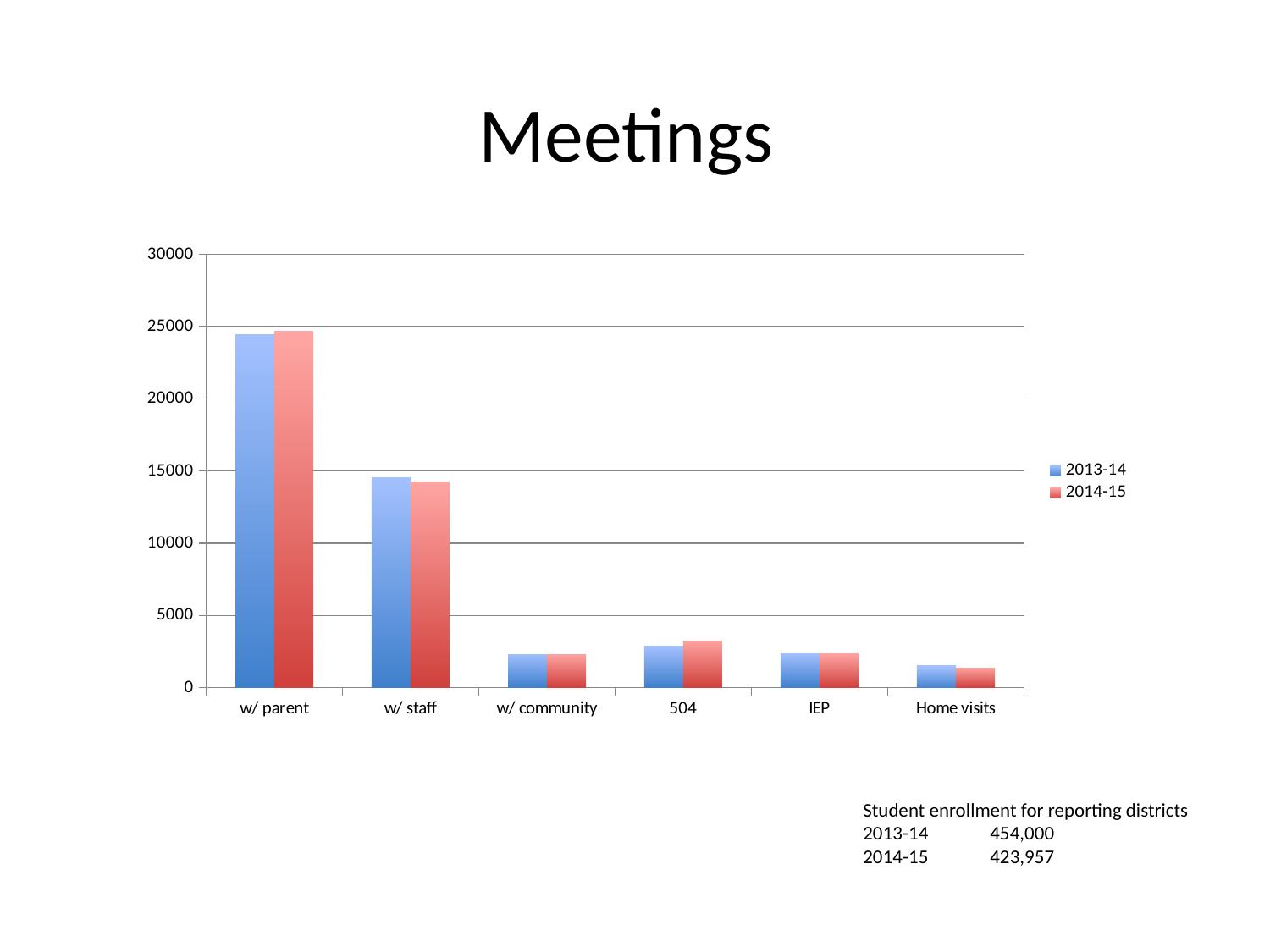
Which category has the highest number of meetings for 2013-14? w/ parent Is the 2014-15 value for w/ staff greater or less than 15000? less How many series does the legend list? 2 Is the 2013-14 value for w/ staff greater or less than 10000? greater What kind of chart is shown on the slide? bar chart For 2014-15, which is larger: 504 or Home visits? 504 Is the 2013-14 value for w/ parent greater or less than 20000? greater How many categories are shown on the x axis? 6 Which category has the lowest number of meetings for 2014-15? Home visits For 2013-14, which is larger: w/ parent or w/ staff? w/ parent What is the title of the chart? Meetings